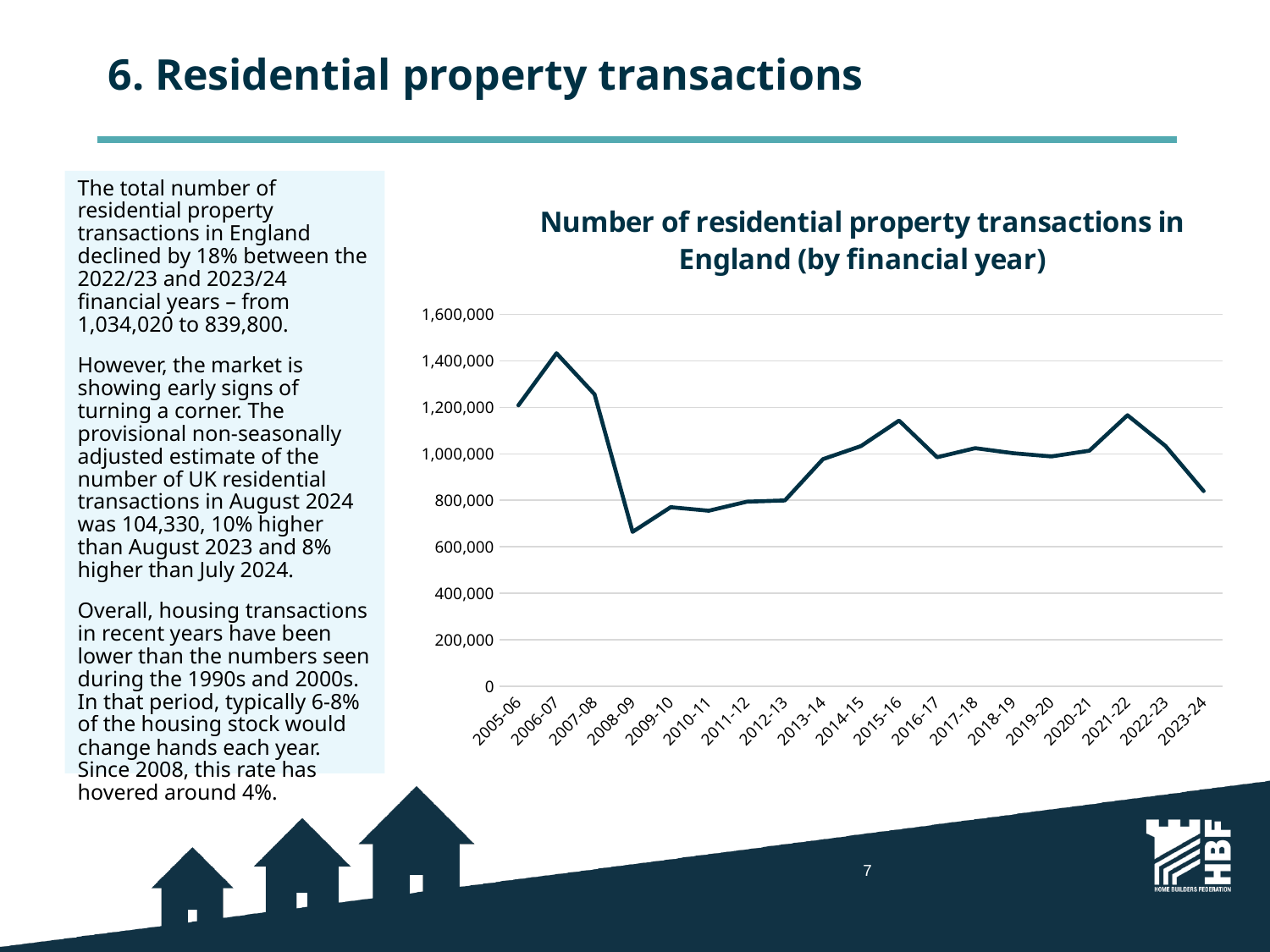
Is the value for 2023-24 greater or less than 800,000? greater Is the value for 2008-09 greater or less than 800,000? less Which financial year has the highest number of residential property transactions in the chart? 2006-07 Is the value for 2006-07 greater or less than 1,400,000? greater Which financial year has the lowest number of residential property transactions in the chart? 2008-09 Do the values rise or fall from 2021-22 to 2023-24? fall Which is larger, the value for 2013-14 or the value for 2010-11? 2013-14 What is the title of the chart? Number of residential property transactions in England (by financial year) Which is larger, the value for 2021-22 or the value for 2023-24? 2021-22 What kind of chart is shown on the slide? line chart How many financial years are plotted on the x axis of the chart? 19